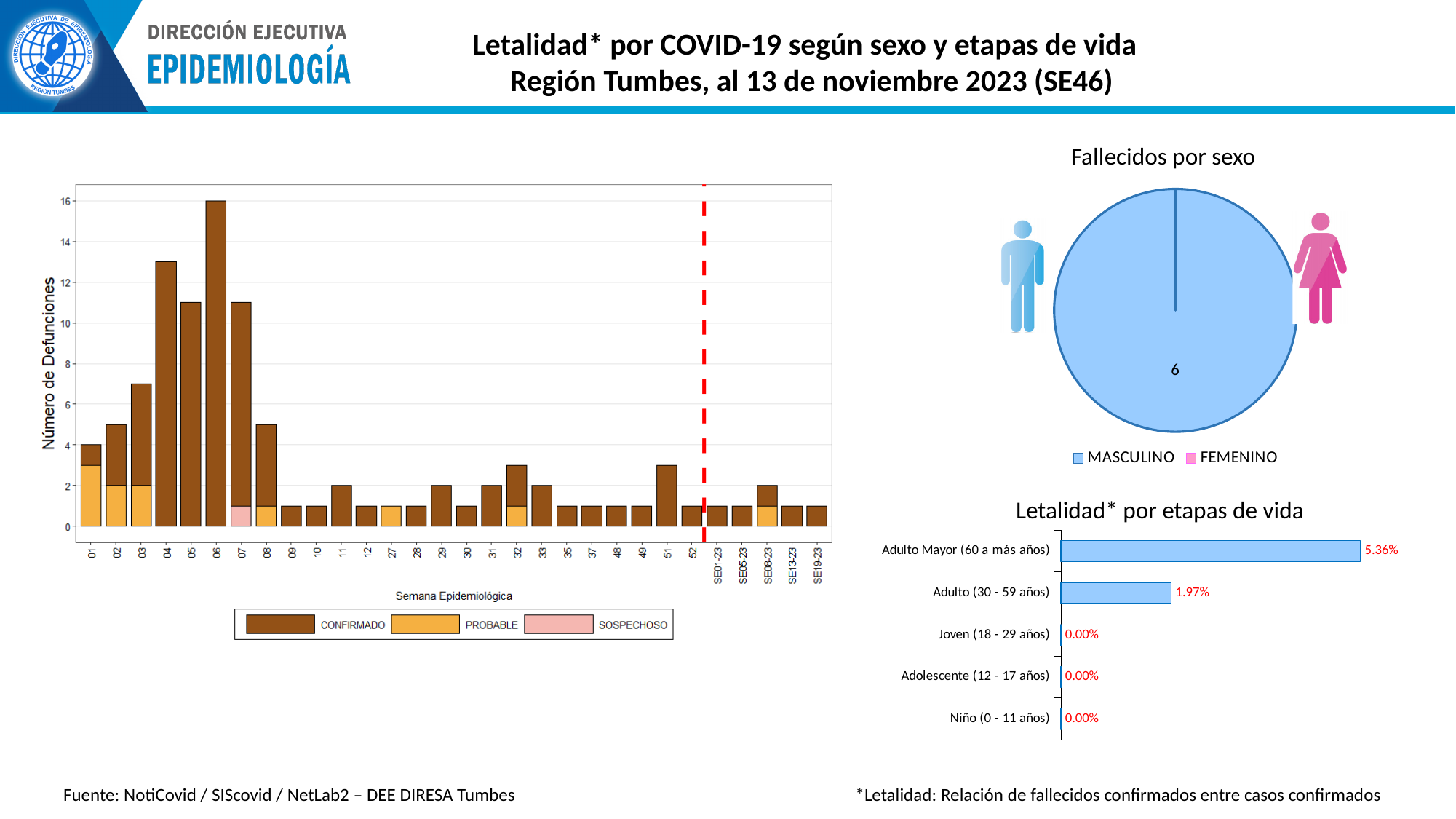
In the 'Letalidad* por etapas de vida' chart, what is the difference between the values for Adulto Mayor (60 a más años) and Adulto (30 - 59 años)? 3.39% In the 'Letalidad* por etapas de vida' chart, what is the value for Joven (18 - 29 años)? 0.00% In the 'Letalidad* por etapas de vida' chart, which age group has the highest value? Adulto Mayor (60 a más años) How many entries does the legend of the 'Fallecidos por sexo' pie chart list? 2 In the 'Letalidad* por etapas de vida' chart, what is the value for Adulto (30 - 59 años)? 1.97% In the bar chart on the left (Número de Defunciones by Semana Epidemiológica), which week has the highest number of deaths? 06 In the 'Letalidad* por etapas de vida' chart, what is the value for Adulto Mayor (60 a más años)? 5.36% In the bar chart on the left, is the value for week 04 greater or less than 12? greater How many series does the legend of the bar chart on the left list? 3 In the 'Letalidad* por etapas de vida' chart, how many age groups are shown? 5 In the bar chart on the left, what is the total number of deaths for week 06? 16 In the 'Fallecidos por sexo' pie chart, what value is shown for MASCULINO? 6